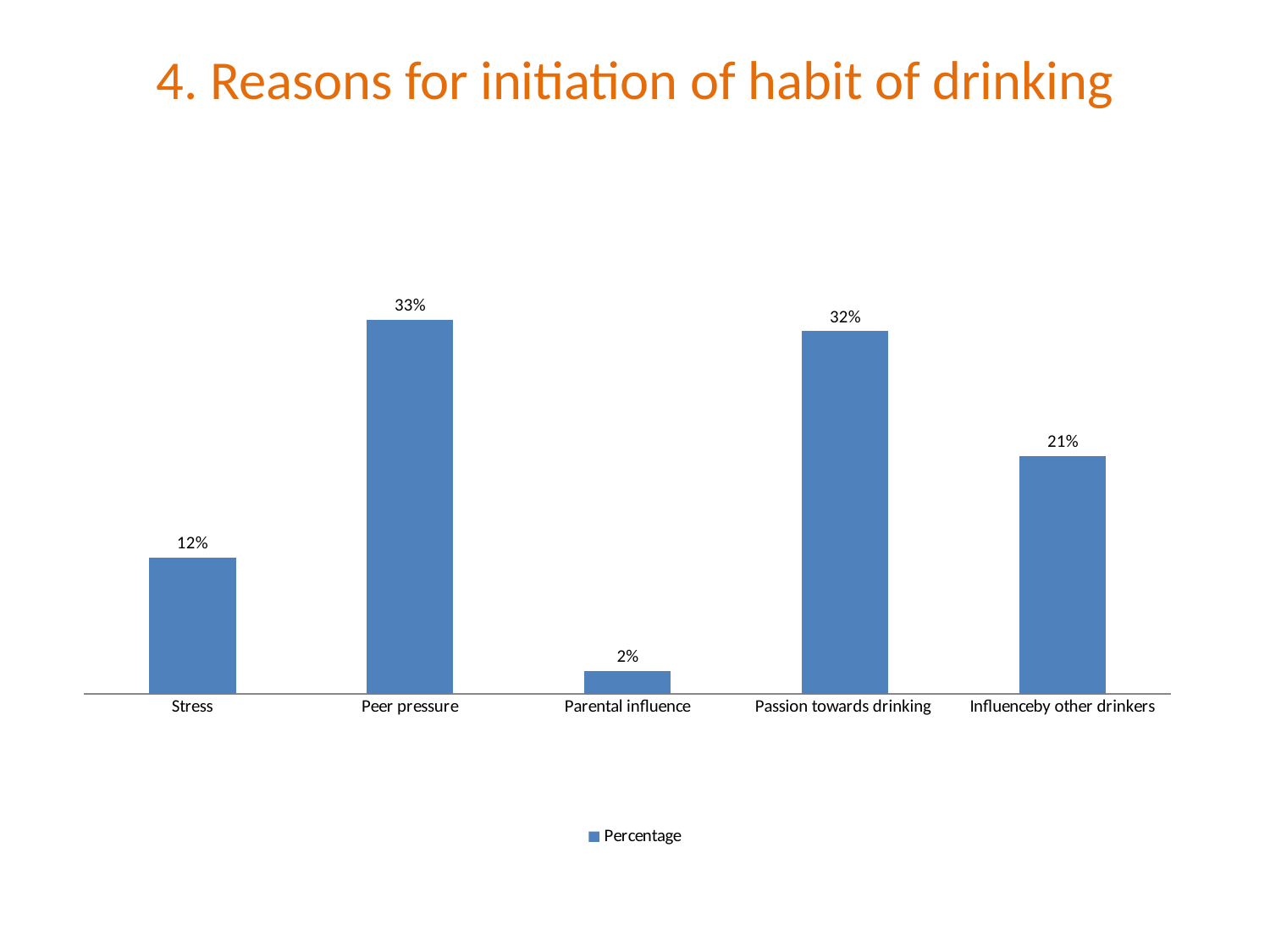
What kind of chart is shown on the slide? Bar chart What is the percentage for Parental influence? 2% Which is larger, the percentage for Stress or the percentage for Influenceby other drinkers? Influenceby other drinkers What is the name of the series shown in the legend? Percentage How many series does the legend list? 1 What is the percentage for Influenceby other drinkers? 21% Which reason has the highest percentage? Peer pressure Which reason has the lowest percentage? Parental influence What is the percentage for Stress? 12% What is the percentage for Peer pressure? 33% What is the difference between the percentages for Passion towards drinking and Influenceby other drinkers? 11% How many reasons are shown on the chart? 5